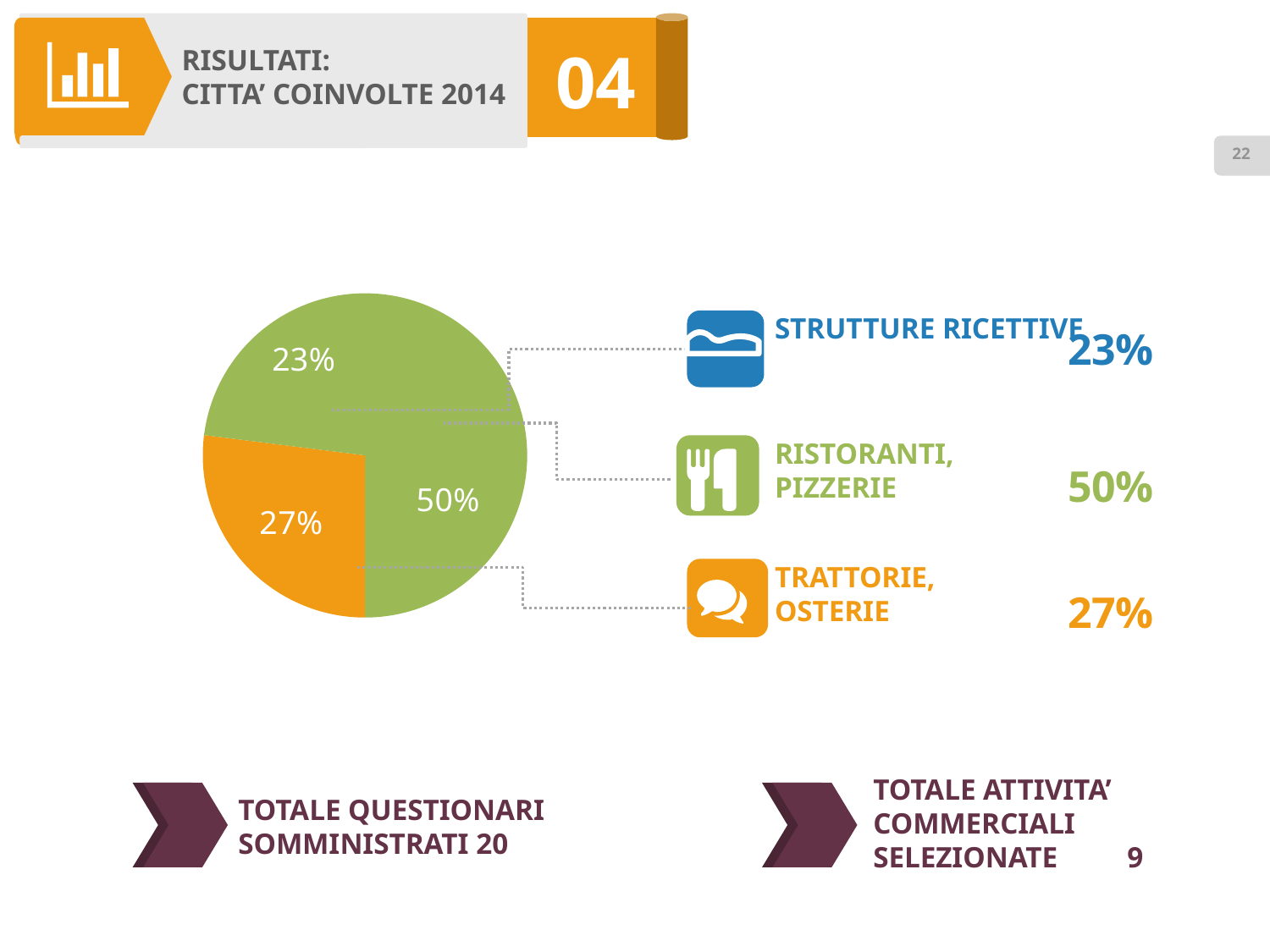
What is the difference in percentage points between Trattorie, Osterie and Strutture Ricettive? 4 What kind of chart is shown on the slide? pie chart How many categories are shown in the pie chart? 3 What colour is the slice for Trattorie, Osterie in the pie chart? orange What is the title shown in the header of the slide? RISULTATI: CITTA' COINVOLTE 2014 What share of the pie is labelled for Ristoranti, Pizzerie? 50% What share of the pie is labelled for Trattorie, Osterie? 27% Which category has the largest slice of the pie? Ristoranti, Pizzerie What share of the pie is labelled for Strutture Ricettive? 23% What is the difference in percentage points between Ristoranti, Pizzerie and Trattorie, Osterie? 23 Which is larger, the share for Trattorie, Osterie or the share for Strutture Ricettive? Trattorie, Osterie Which category has the smallest slice of the pie? Strutture Ricettive